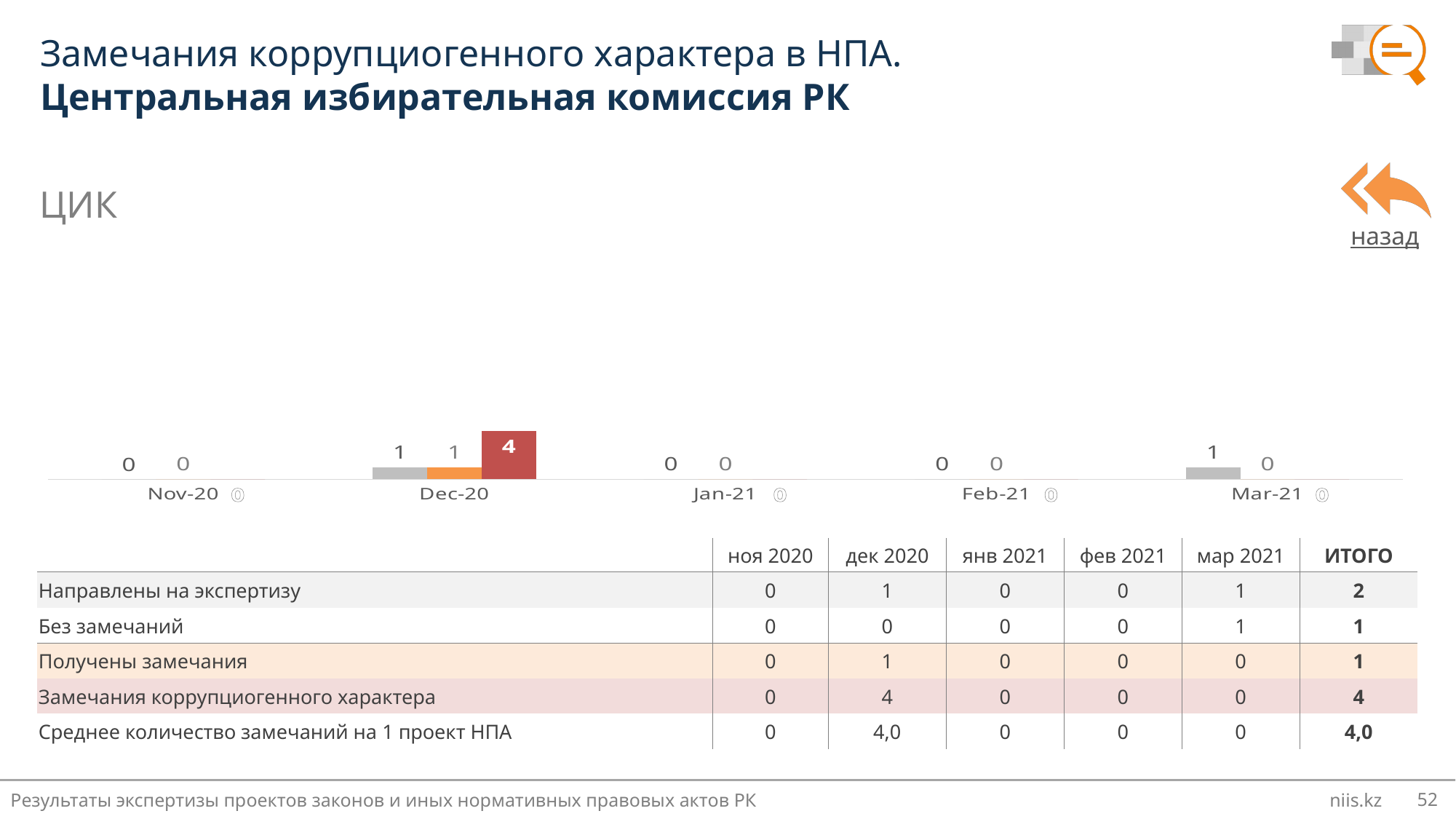
Which is larger for Dec-20, the red bar or the orange bar? the red bar What is the last month shown on the x axis of the chart? Mar-21 What is the first month shown on the x axis of the chart? Nov-20 What kind of chart is shown on the slide? bar chart What is the value of the grey bar for Dec-20? 1 How many months are shown on the x axis of the chart? 5 What is the value of the red bar for Dec-20? 4 What is the value of the grey bar for Mar-21? 1 Which month has the tallest bar in the chart? Dec-20 What is the value of the orange bar for Dec-20? 1 What is the value of the grey bar for Nov-20? 0 What is the difference between the red bar and the grey bar for Dec-20? 3